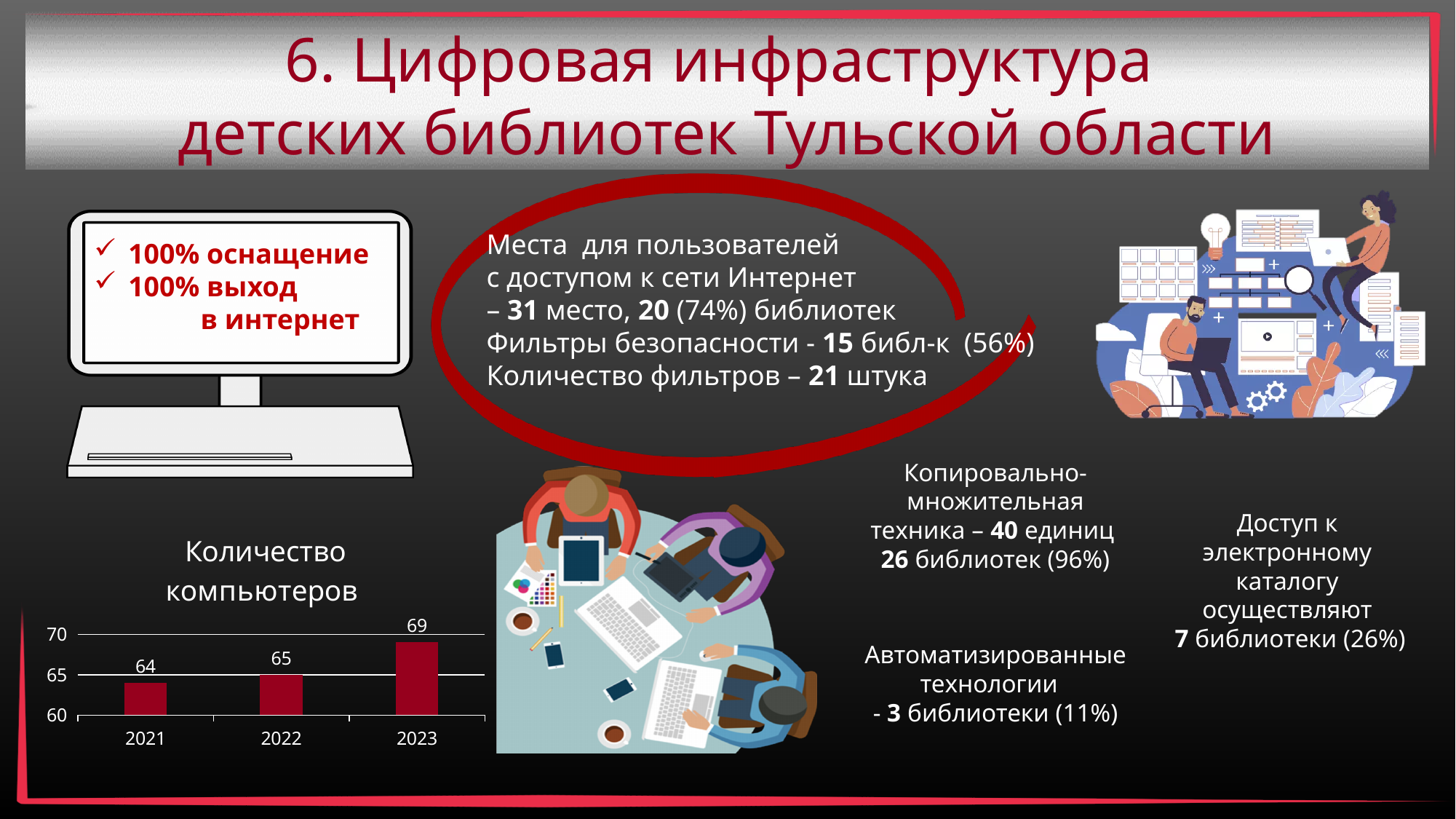
In the 'Количество компьютеров' chart, which is larger: the value for 2022 or the value for 2023? 2023 What type of chart is 'Количество компьютеров'? bar chart What is the value for 2023 in the 'Количество компьютеров' chart? 69 Do the values in the 'Количество компьютеров' chart rise or fall from 2021 to 2023? rise Which year has the lowest value in the 'Количество компьютеров' chart? 2021 Is the value for 2021 in the 'Количество компьютеров' chart greater or less than 65? less What is the value for 2021 in the 'Количество компьютеров' chart? 64 What is the difference between the 2023 and 2021 values in the 'Количество компьютеров' chart? 5 Which year has the highest value in the 'Количество компьютеров' chart? 2023 What is the value for 2022 in the 'Количество компьютеров' chart? 65 What is the difference between the 2023 and 2022 values in the 'Количество компьютеров' chart? 4 How many years are shown in the 'Количество компьютеров' chart? 3